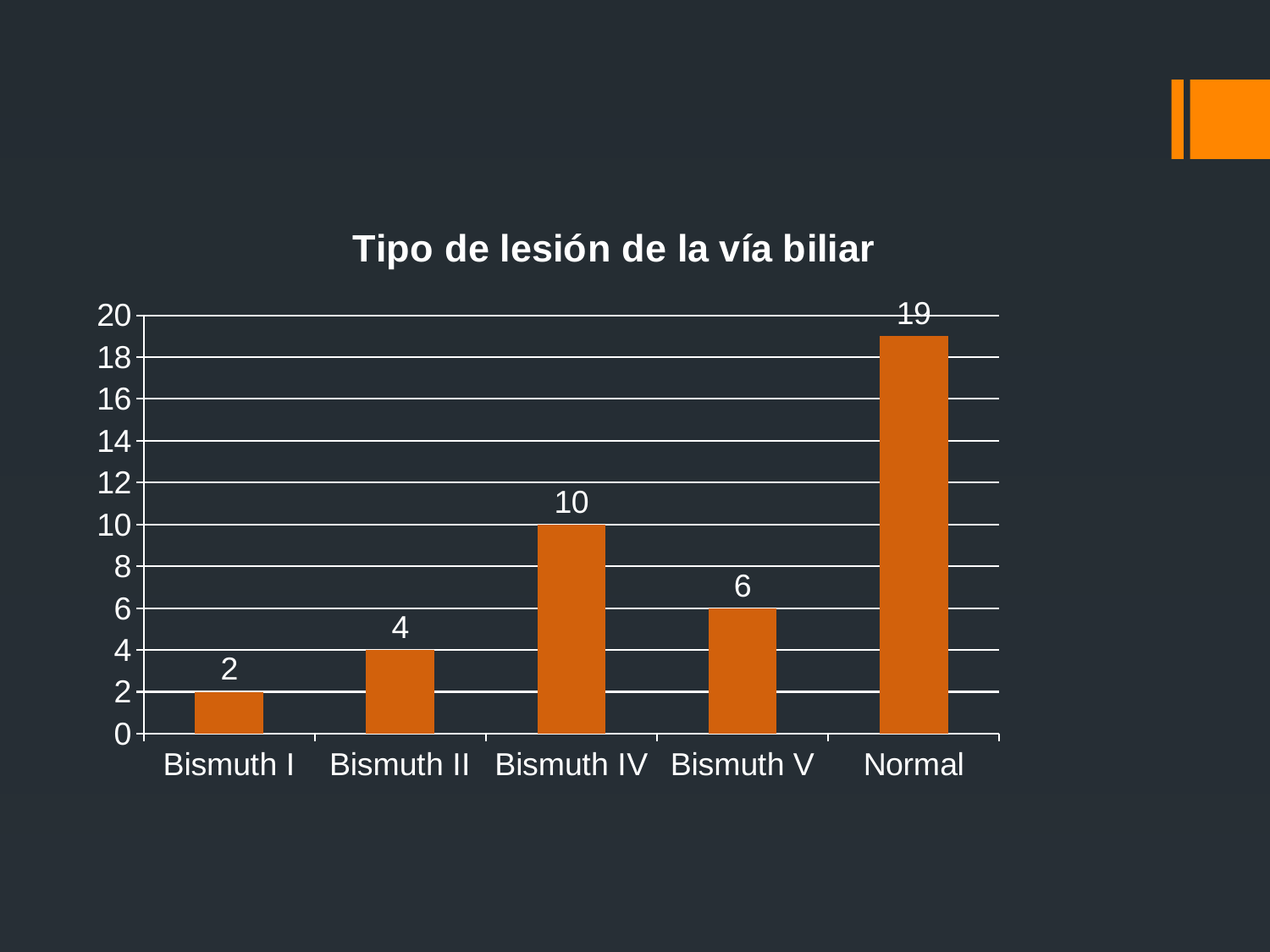
How many categories are shown on the x axis? 5 What is the title of the chart? Tipo de lesión de la vía biliar Which category has the highest value? Normal Which category has the lowest value? Bismuth I Is the value for Bismuth IV greater or less than 8? greater Which is larger, the value for Bismuth II or the value for Bismuth V? Bismuth V What is the value for Bismuth I? 2 What is the value for Normal? 19 What is the value for Bismuth IV? 10 What is the difference between the values for Normal and Bismuth IV? 9 What is the difference between the values for Bismuth V and Bismuth II? 2 What kind of chart is shown on the slide? bar chart